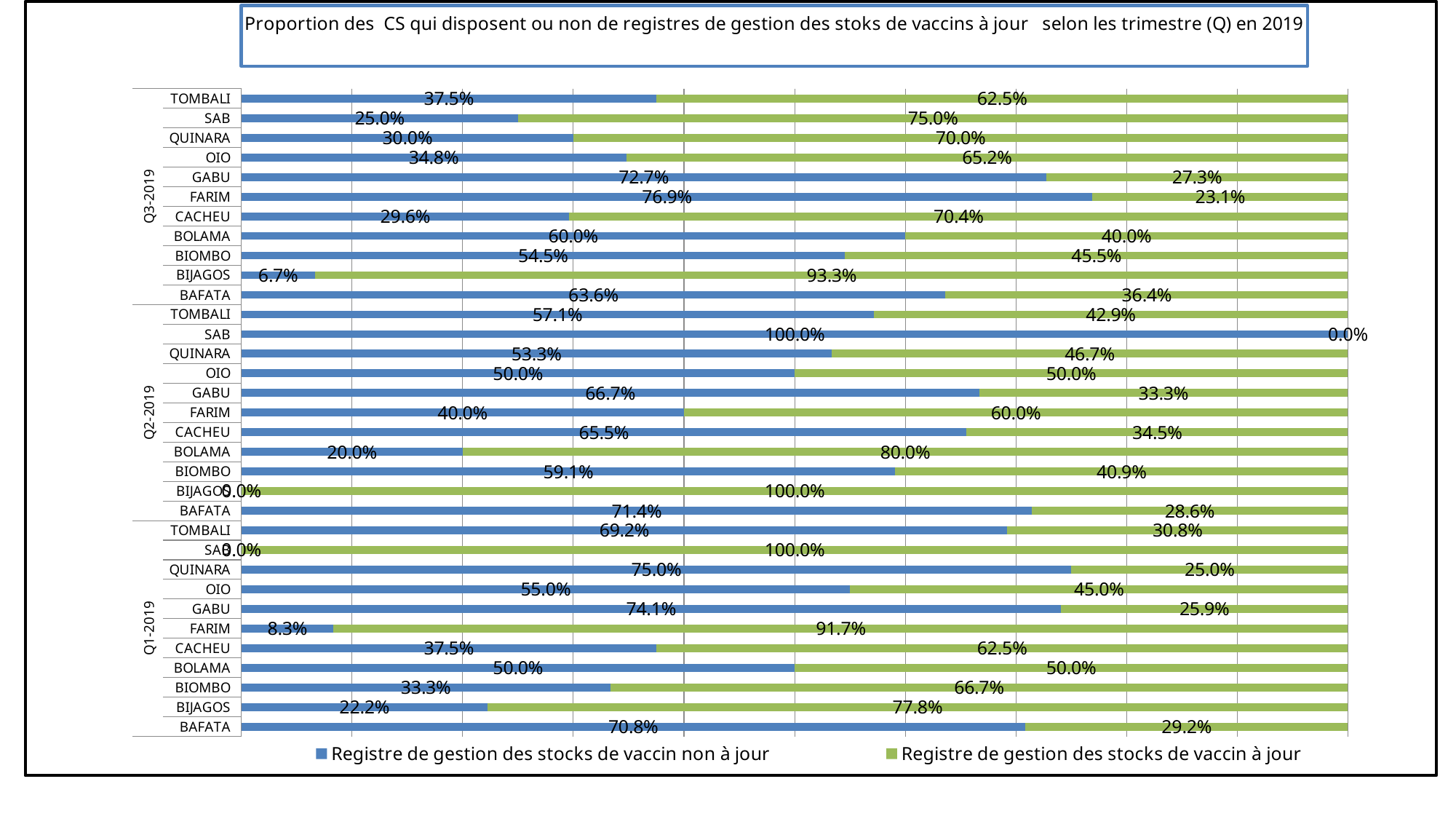
What is the difference between the 'à jour' value for BIJAGOS in Q3-2019 and the 'à jour' value for BIJAGOS in Q1-2019? 15.5% How many series does the legend list? 2 How many regions are listed for each quarter in the chart? 11 In Q3-2019, which region has the highest value for 'Registre de gestion des stocks de vaccin non à jour'? FARIM What is the total of the two segments of the bar for OIO in Q2-2019? 100.0% What is the value of 'Registre de gestion des stocks de vaccin non à jour' for BOLAMA in Q2-2019? 20.0% Which is larger: the 'non à jour' value for GABU in Q3-2019 or the 'non à jour' value for GABU in Q2-2019? GABU in Q3-2019 What kind of chart is shown on the slide? Stacked bar chart Which colour represents 'Registre de gestion des stocks de vaccin à jour' in the legend? Green In Q1-2019, which region has the lowest value for 'Registre de gestion des stocks de vaccin à jour'? QUINARA What is the value of 'Registre de gestion des stocks de vaccin à jour' for FARIM in Q1-2019? 91.7% What is the value of 'Registre de gestion des stocks de vaccin non à jour' for BIJAGOS in Q3-2019? 6.7%